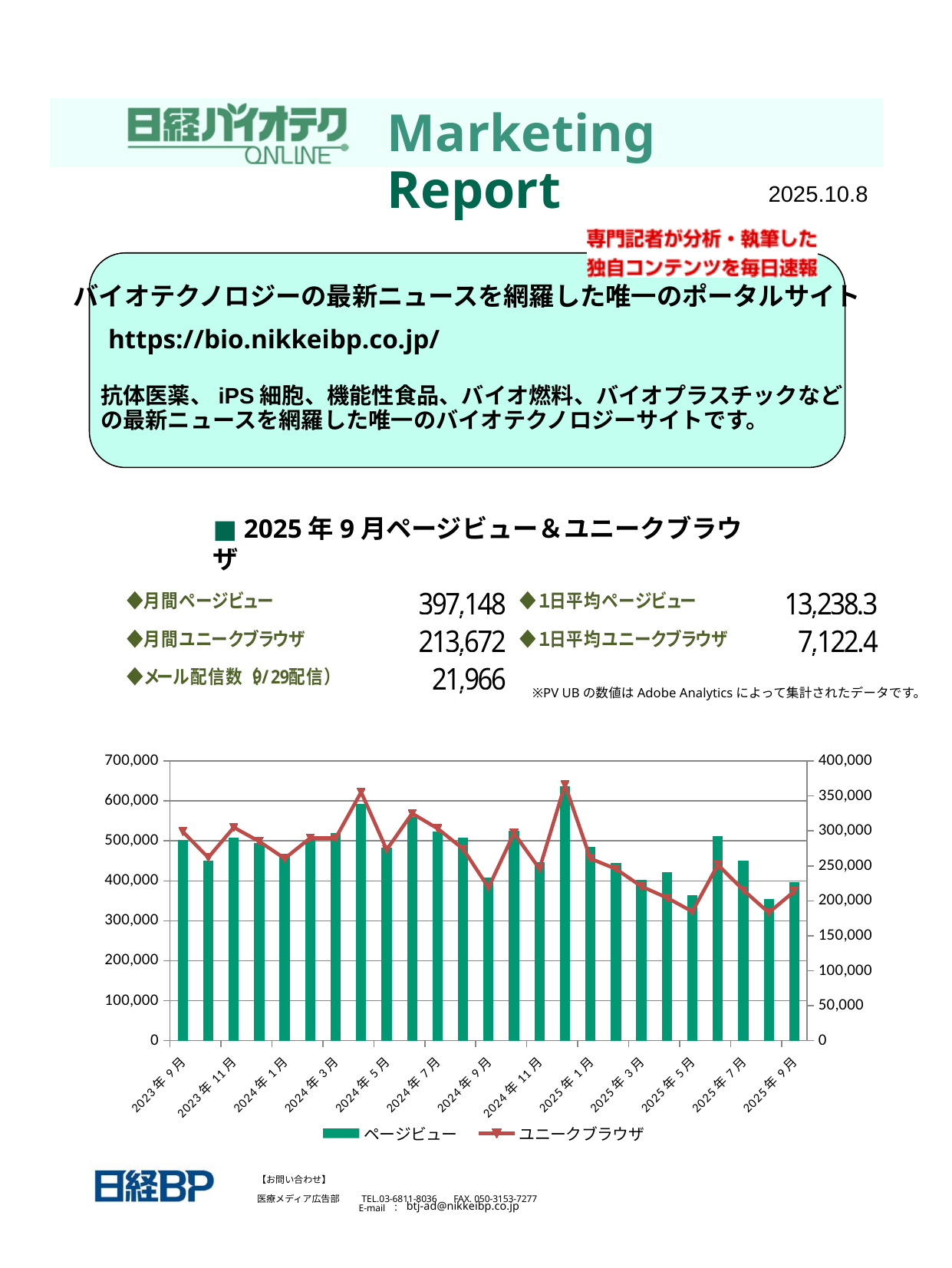
Is the ユニークブラウザ value for 2025年5月 greater or less than 200,000 on the right axis? less What is the monthly unique browser (月間ユニークブラウザ) value for 2025年9月 shown on the slide? 213,672 How many monthly bars are plotted in the chart? 25 Do the ページビュー bars rise or fall from 2025年1月 to 2025年5月? fall What are the two series named in the chart legend? ページビュー and ユニークブラウザ What is the monthly page view (月間ページビュー) value for 2025年9月 shown on the slide? 397,148 Which is larger, the ページビュー bar for 2024年5月 or for 2024年6月? 2024年6月 Is the ページビュー value for 2025年1月 greater or less than 600,000? less How many series does the chart legend list? 2 Is the ページビュー value for 2025年5月 greater or less than 400,000? less What kind of chart is shown on the slide? Combination bar and line chart Which month has the highest ページビュー bar in the chart? 2024年12月